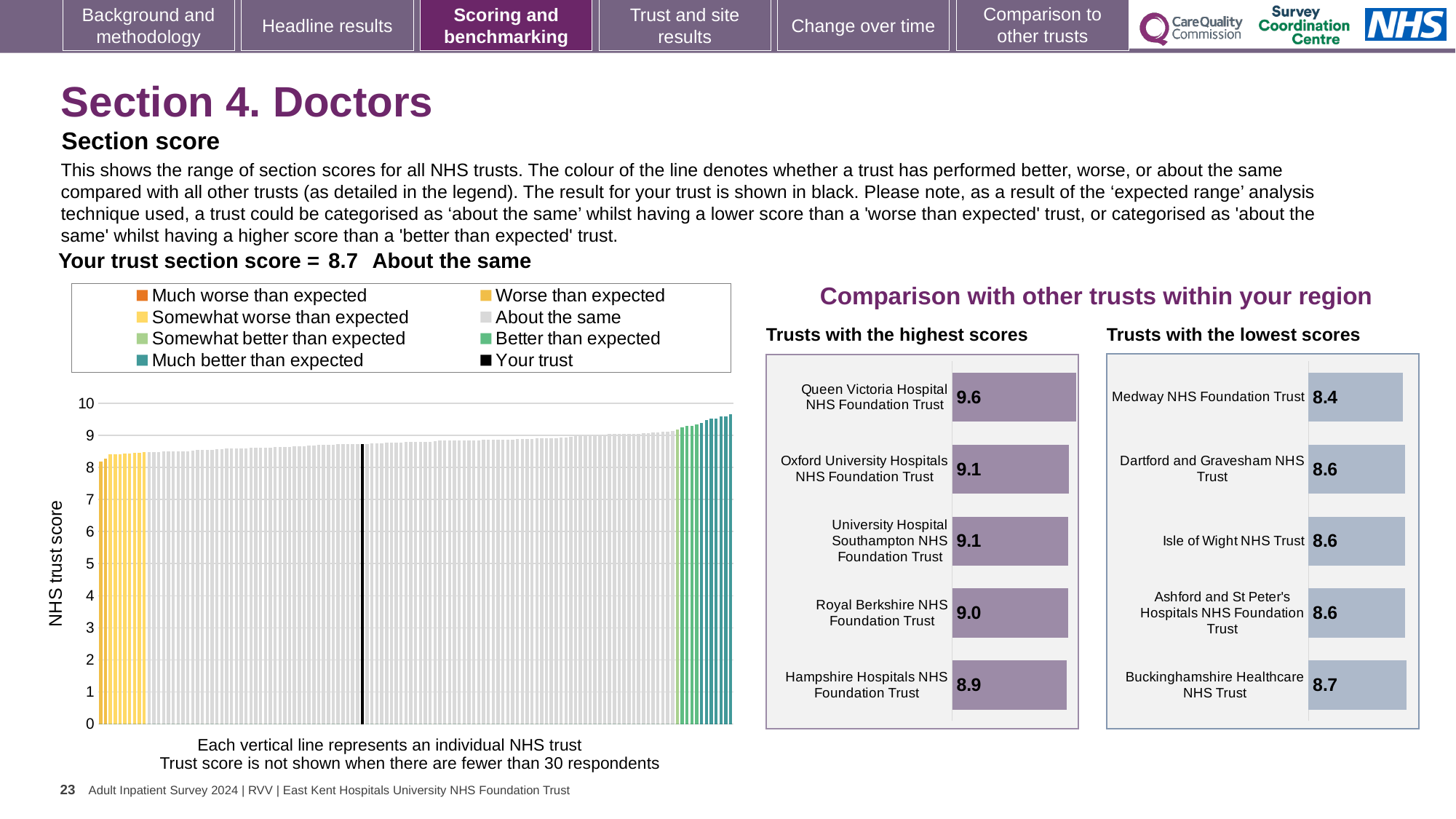
In the 'Trusts with the highest scores' chart, what is the difference between the scores of Queen Victoria Hospital NHS Foundation Trust and Hampshire Hospitals NHS Foundation Trust? 0.7 In the 'Trusts with the lowest scores' chart, what is the difference between the scores of Buckinghamshire Healthcare NHS Trust and Medway NHS Foundation Trust? 0.3 How many trusts are shown in the 'Trusts with the highest scores' chart? 5 In the 'Trusts with the lowest scores' chart, what is the score for Buckinghamshire Healthcare NHS Trust? 8.7 How many entries does the legend of the large 'NHS trust score' chart list? 8 In the 'Trusts with the lowest scores' chart, what is the score for Medway NHS Foundation Trust? 8.4 In the 'Trusts with the highest scores' chart, which has the larger score: Royal Berkshire NHS Foundation Trust or Hampshire Hospitals NHS Foundation Trust? Royal Berkshire NHS Foundation Trust In the 'Trusts with the highest scores' chart, what is the score for Queen Victoria Hospital NHS Foundation Trust? 9.6 In the 'Trusts with the highest scores' chart, which trust has the highest score? Queen Victoria Hospital NHS Foundation Trust In the 'Trusts with the lowest scores' chart, which trust has the lowest score? Medway NHS Foundation Trust What is the y-axis title of the large chart on the left of the slide? NHS trust score What kind of chart is the 'Trusts with the lowest scores' chart? Bar chart